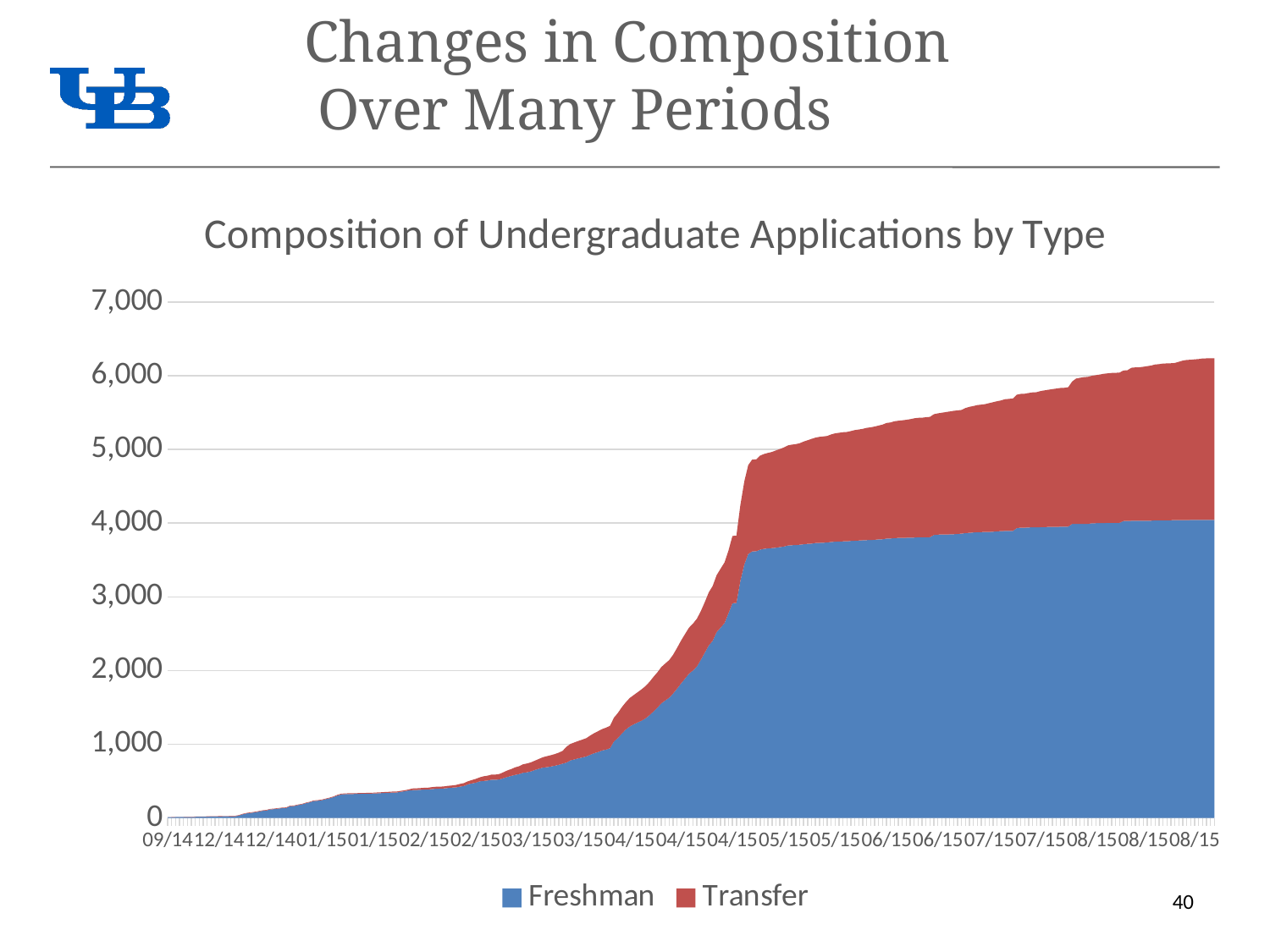
What is the title of the chart? Composition of Undergraduate Applications by Type At the right end of the chart (08/15), is the total of Freshman and Transfer applications greater or less than 7,000? less Which series is shown in blue in the chart? Freshman How many series does the legend list? 2 What kind of chart is shown on the slide? Stacked area chart Around 01/15, is the total of Freshman and Transfer applications greater or less than 1,000? less What is the highest value shown on the y axis? 7,000 Do the total applications rise or fall along the x axis from 09/14 to 08/15? Rise At the right end of the chart (08/15), which series is larger, Freshman or Transfer? Freshman At the right end of the chart (08/15), is the total of Freshman and Transfer applications greater or less than 6,000? greater